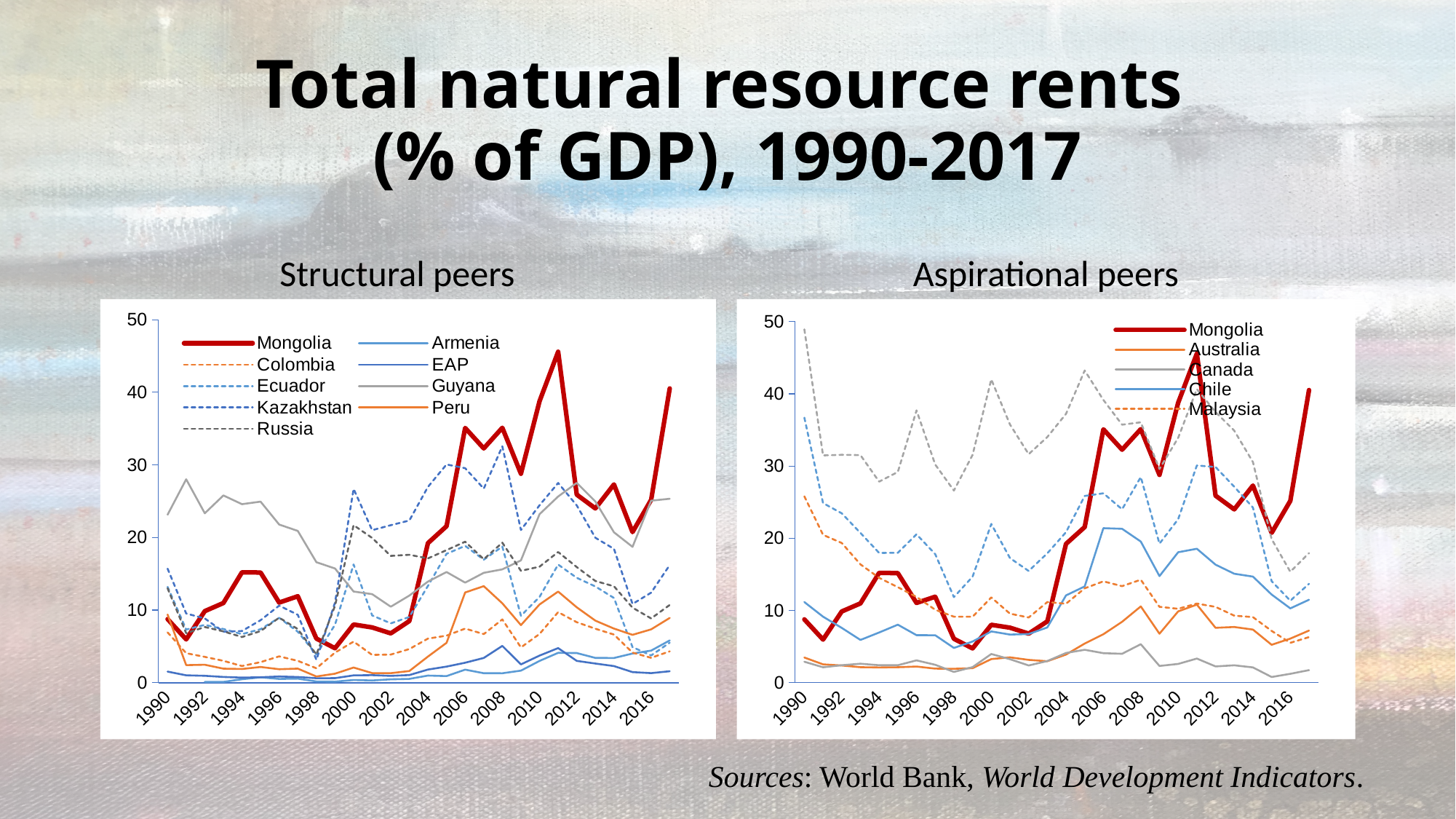
What kind of chart is the Structural peers chart? line chart In the Structural peers chart, is the value for Armenia in 2008 greater or less than 10? less In the Aspirational peers chart, which is larger in 1990, Canada or Mongolia? Mongolia In the Structural peers chart, which is larger in 2011, Mongolia or Guyana? Mongolia What is the highest value shown on the y axis of the Aspirational peers chart? 50 In the Aspirational peers chart, does the Mongolia line rise or fall overall from 2004 to 2011? rise Which series is drawn with the thick red line in both charts? Mongolia How many series does the legend of the Aspirational peers chart list? 5 In the Aspirational peers chart, is the value for Canada in 1990 greater or less than 40? less How many series does the legend of the Structural peers chart list? 9 In the Aspirational peers chart, is the value for Mongolia in 1999 greater or less than 10? less